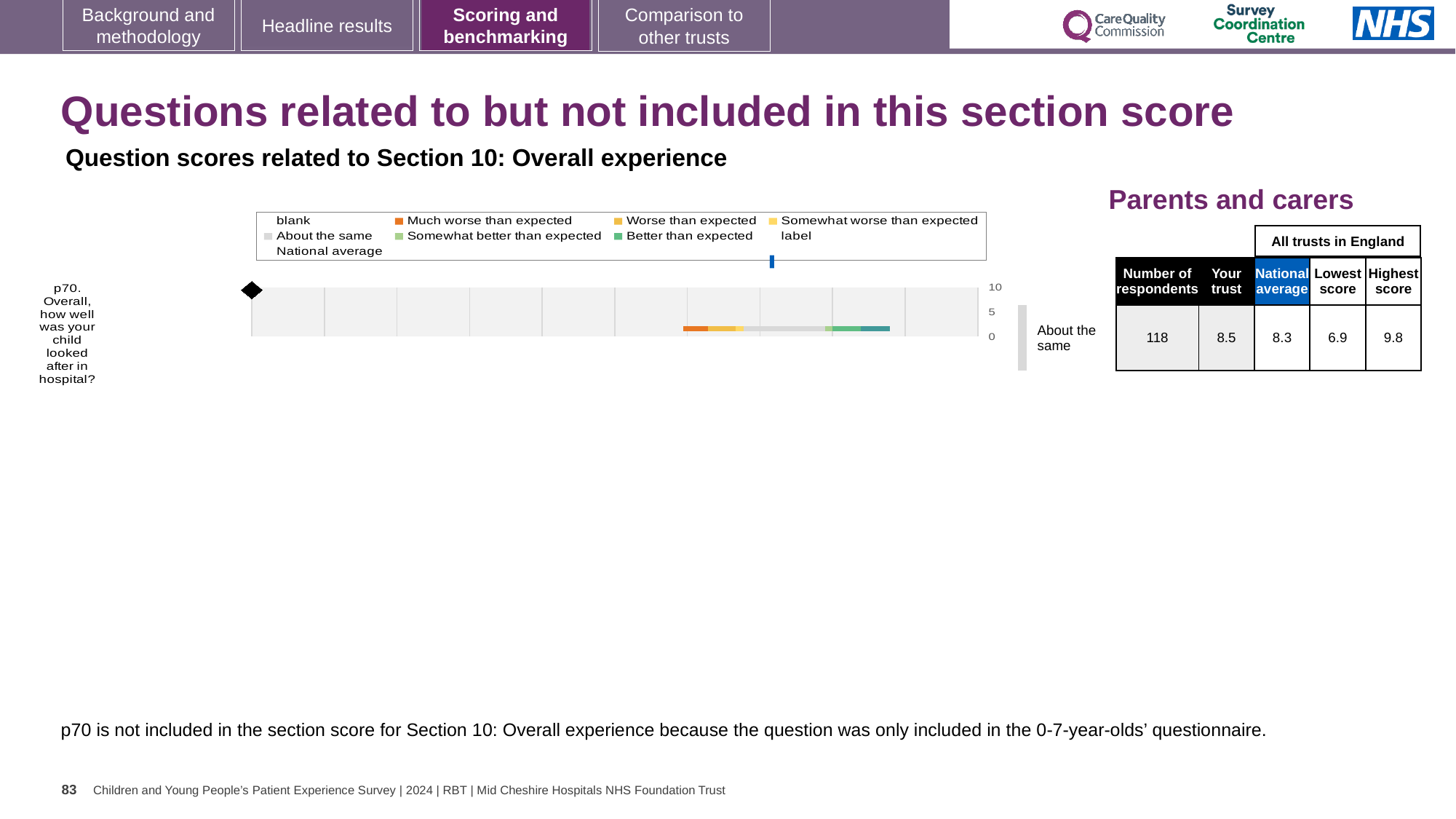
How many questions are plotted on the chart? 1 What kind of chart is used to show the p70 result? bar chart What is the difference between the highest and lowest trust scores for question p70? 2.9 What is the highest score among all trusts in England for question p70? 9.8 Which benchmarking category does the trust's result for p70 fall into? About the same What is the lowest score among all trusts in England for question p70? 6.9 Which is higher for question p70: the trust's score or the national average? Your trust Is the trust's score for p70 greater or less than 5 on the chart's axis? greater What is the national average score for question p70? 8.3 By how much does the trust's score for p70 differ from the national average? 0.2 How many respondents answered question p70 for this trust? 118 What is the 'Your trust' score for question p70 (Overall, how well was your child looked after in hospital?)? 8.5